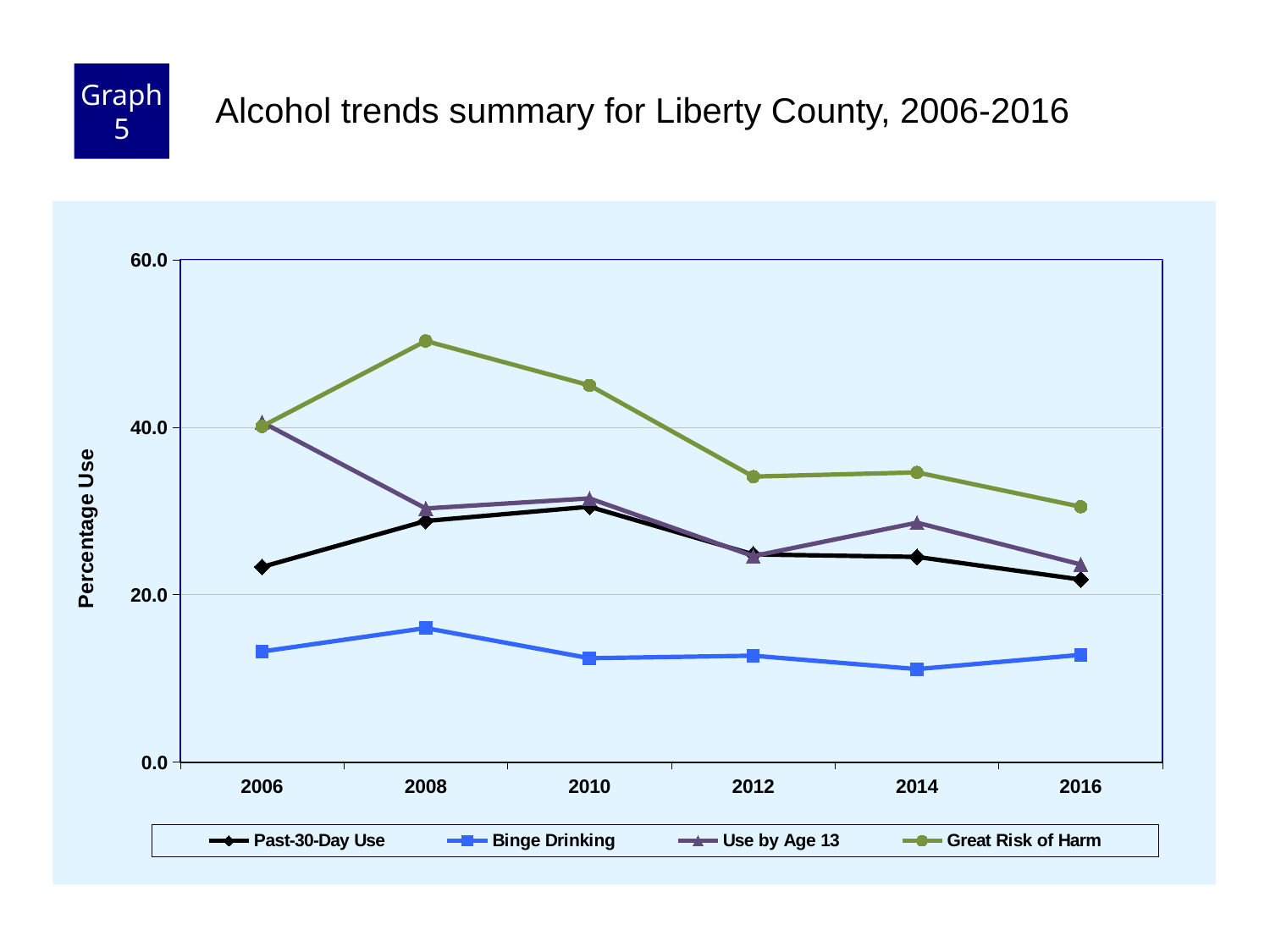
How many years are plotted along the x axis? 6 What is the label on the y axis? Percentage Use Does the Great Risk of Harm series rise or fall from 2010 to 2016? fall What is the title of the chart? Alcohol trends summary for Liberty County, 2006-2016 Which is larger in 2014: Use by Age 13 or Past-30-Day Use? Use by Age 13 How many series does the legend list? 4 Is the value for Binge Drinking in 2006 greater or less than 20.0? less Is the value for Past-30-Day Use in 2010 greater or less than 20.0? greater In which year does the Great Risk of Harm series reach its highest value? 2008 Is the value for Great Risk of Harm in 2008 greater or less than 40.0? greater What kind of chart is shown on the slide? line chart In which year is the Binge Drinking series at its lowest? 2014